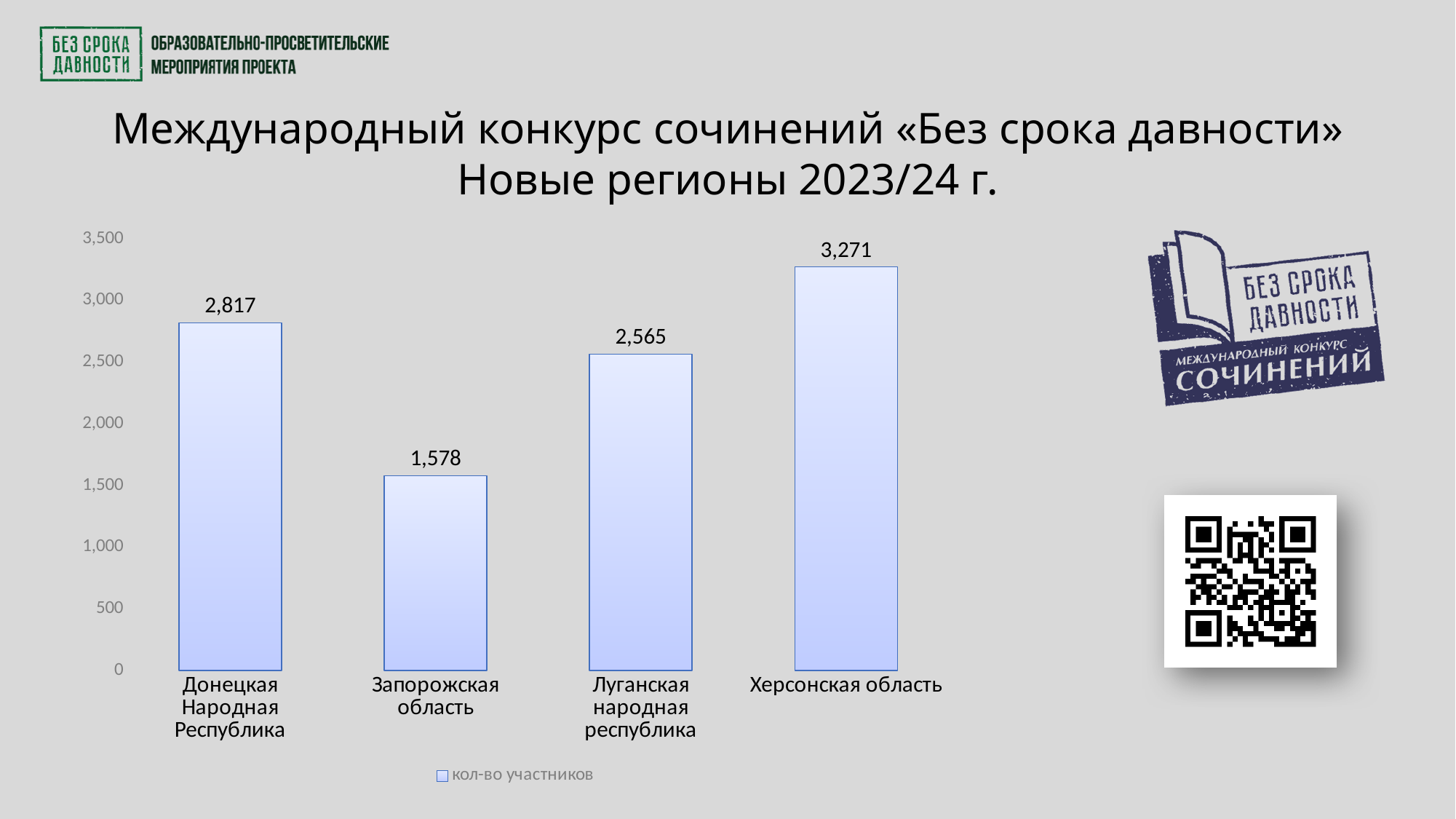
How many regions are shown in the chart? 4 What is the value for Луганская народная республика? 2,565 Which is larger, the value for Донецкая Народная Республика or Луганская народная республика? Донецкая Народная Республика What kind of chart is shown on the slide? bar chart What is the value for Донецкая Народная Республика? 2,817 What series name does the legend show? кол-во участников What is the value for Запорожская область? 1,578 Which region has the highest value? Херсонская область What is the value for Херсонская область? 3,271 Which region has the lowest value? Запорожская область What is the difference between the values for Луганская народная республика and Запорожская область? 987 What is the difference between the values for Херсонская область and Донецкая Народная Республика? 454